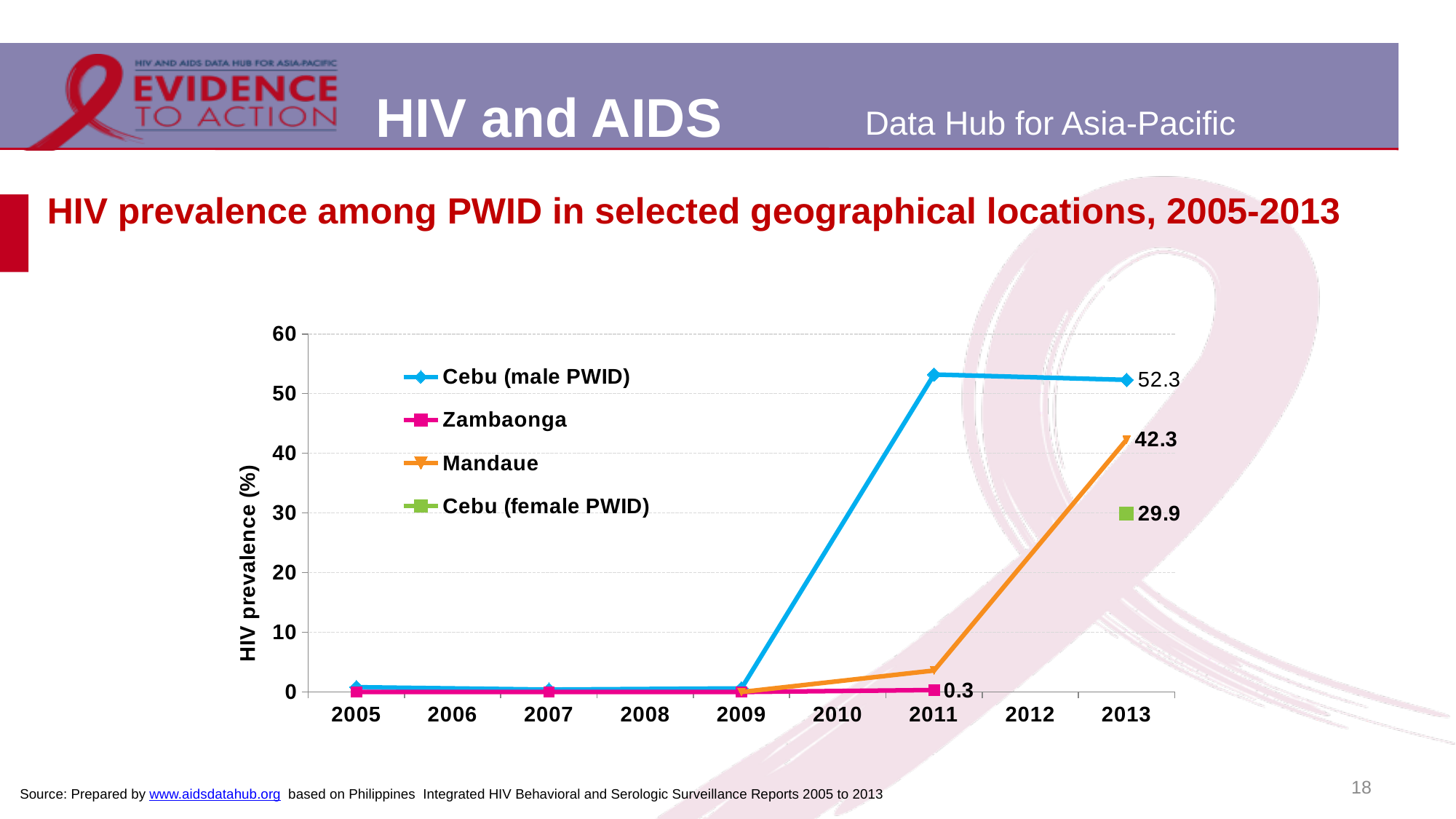
What is the label of the y axis? HIV prevalence (%) Is the value for Mandaue in 2011 greater or less than 10? less What is the HIV prevalence for Cebu (female PWID) in 2013? 29.9 What is the difference between the 2013 values for Cebu (male PWID) and Mandaue? 10 What type of chart is shown on the slide? line chart What is the HIV prevalence for Zambaonga in 2011? 0.3 Does the Cebu (male PWID) line rise or fall between 2009 and 2011? rise How many series does the legend list? 4 What is the HIV prevalence for Mandaue in 2013? 42.3 Which series has the highest value in 2013? Cebu (male PWID) What is the HIV prevalence for Cebu (male PWID) in 2013? 52.3 Which is larger in 2013, the value for Mandaue or the value for Cebu (female PWID)? Mandaue